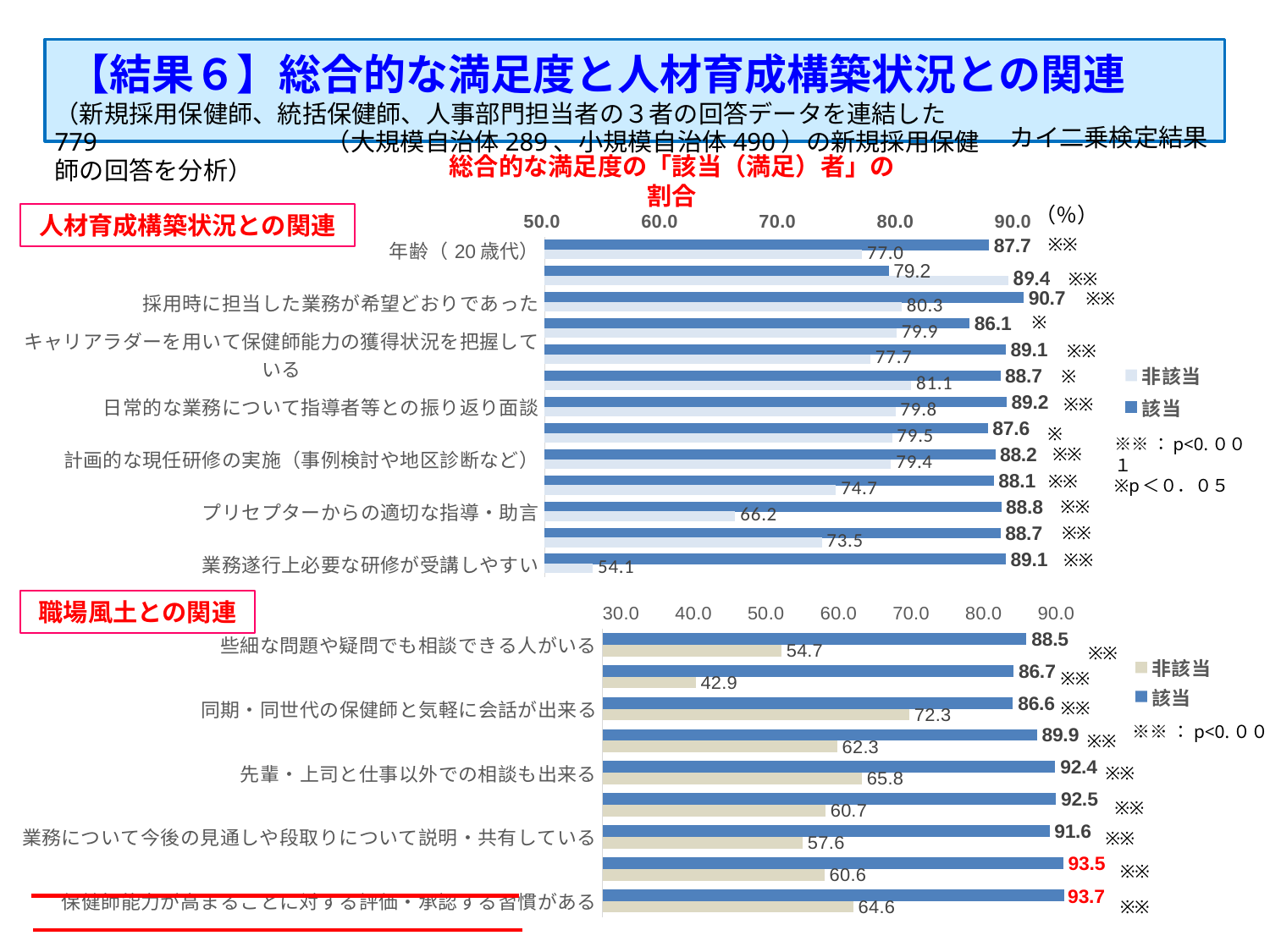
In the top chart (人材育成構築状況との関連), what is the lowest 非該当 value shown? 54.1 In the bottom chart (職場風土との関連), what is the 非該当 value for 些細な問題や疑問でも相談できる人がいる? 54.7 In the bottom chart (職場風土との関連), what is the lowest 非該当 value shown? 42.9 In the top chart (人材育成構築状況との関連), what is the difference between the 該当 and 非該当 values for 業務遂行上必要な研修が受講しやすい? 35.0 What kind of chart is used in the top chart (人材育成構築状況との関連)? bar chart How many series does the legend of the bottom chart (職場風土との関連) list? 2 In the bottom chart (職場風土との関連), what is the 該当 value for 保健師能力が高まることに対する評価・承認する習慣がある? 93.7 In the top chart (人材育成構築状況との関連), is the 非該当 value for 年齢（20歳代） greater or less than 70.0? greater In the top chart (人材育成構築状況との関連), what is the 非該当 value for 業務遂行上必要な研修が受講しやすい? 54.1 In the bottom chart (職場風土との関連), which series has the larger value for 些細な問題や疑問でも相談できる人がいる, 該当 or 非該当? 該当 In the bottom chart (職場風土との関連), what is the difference between the 該当 and 非該当 values for 些細な問題や疑問でも相談できる人がいる? 33.8 In the top chart (人材育成構築状況との関連), what is the 該当 value for 年齢（20歳代）? 87.7